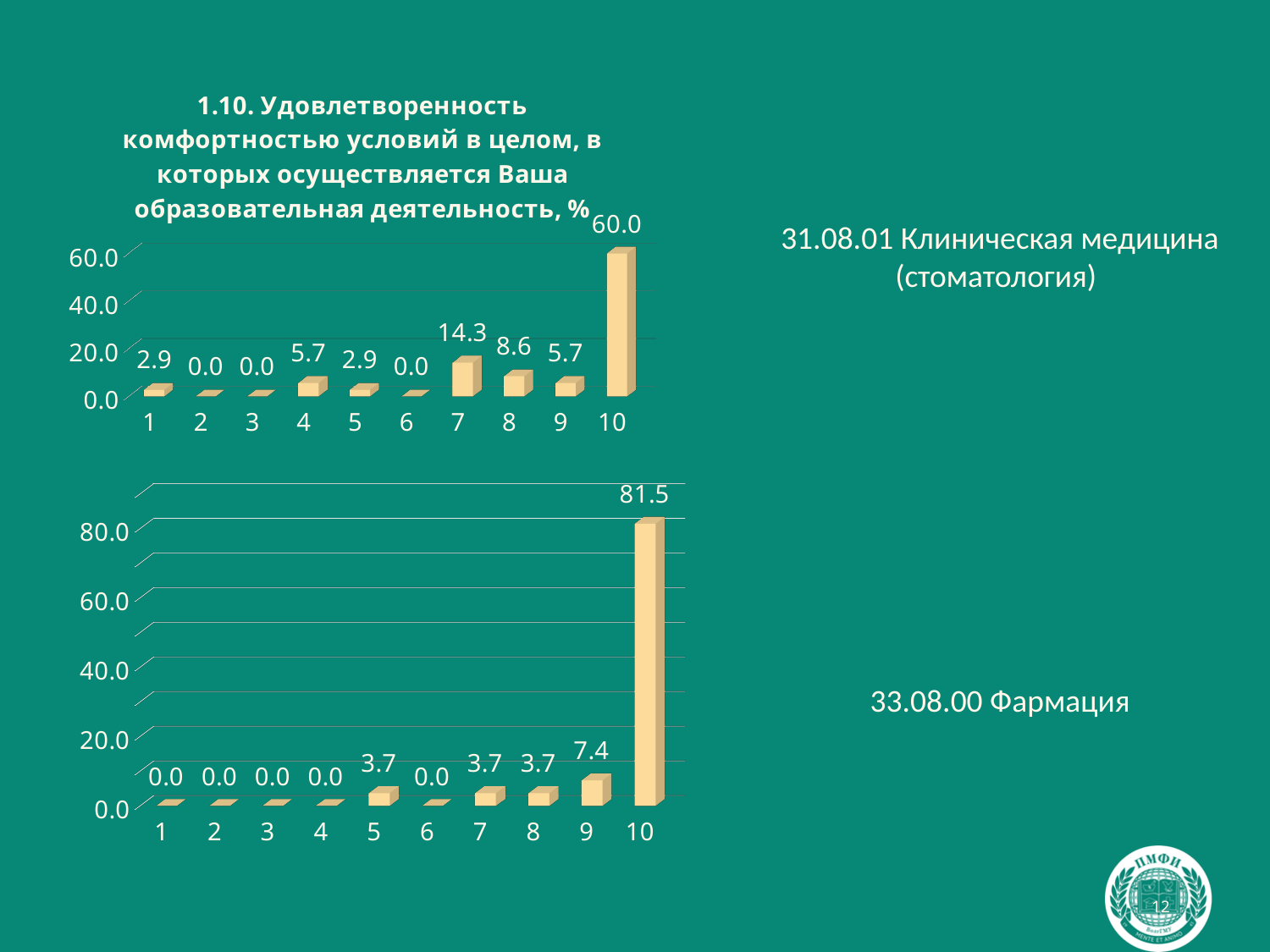
In the top chart, what is the difference between the values for category 7 and category 8? 5.7 What kind of chart is the bottom chart? bar chart In the top chart, which category has the highest value? 10 In the top chart, what is the value for category 7? 14.3 In the bottom chart, what is the difference between the values for category 10 and category 9? 74.1 What is the title of the top chart? 1.10. Удовлетворенность комфортностью условий в целом, в которых осуществляется Ваша образовательная деятельность, % In the top chart, what is the value for category 10? 60.0 In the bottom chart, what is the value for category 10? 81.5 In the bottom chart, how many categories have a value of 0.0? 5 In the top chart, which is larger: the value for category 4 or the value for category 8? category 8 In the bottom chart, what is the value for category 9? 7.4 In the top chart, how many categories are shown on the x axis? 10